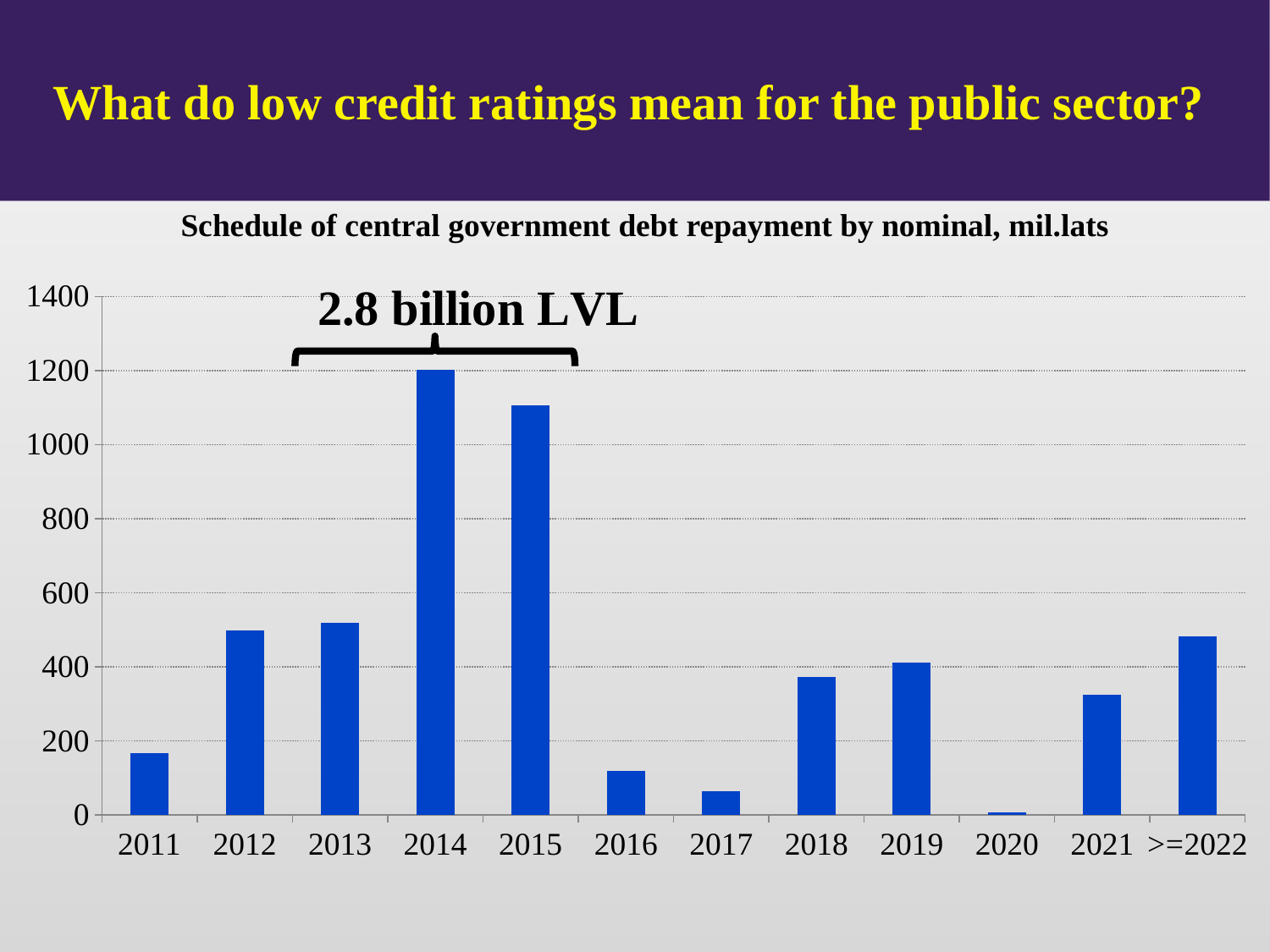
Is the value for >=2022 greater or less than 400? greater Which is larger, the value for 2011 or the value for 2016? 2011 Which is larger, the value for 2014 or the value for 2015? 2014 Which year has the lowest debt repayment in the chart? 2020 Is the value for 2017 greater or less than 100? less What is the title of the chart? Schedule of central government debt repayment by nominal, mil.lats What kind of chart is shown on the slide? Bar chart What total amount does the bracket annotation above the 2013–2015 bars state? 2.8 billion LVL Which year has the highest debt repayment in the chart? 2014 Do the values rise or fall from 2014 to 2017? fall Is the value for 2015 greater or less than 1000? greater How many categories are shown on the x axis of the chart? 12